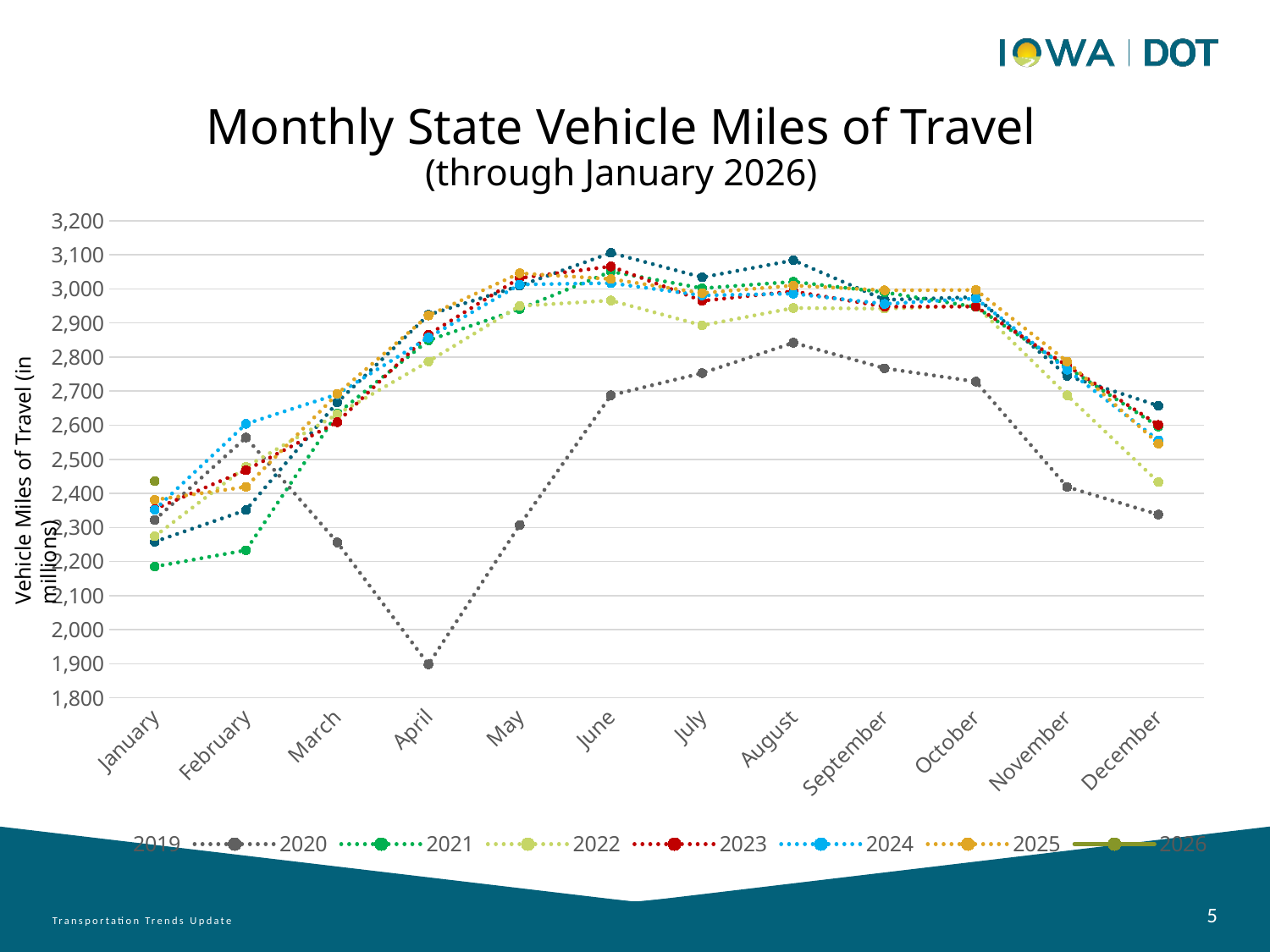
Is the 2020 value for April greater or less than 2,000? less Which series has the lowest value in December? 2020 How many months are shown along the x axis? 12 What is the title of the chart? Monthly State Vehicle Miles of Travel (through January 2026) Is the 2022 value for December greater or less than 2,500? less Is the 2020 value for June greater or less than 2,600? greater What kind of chart is shown on the slide? line chart Which month has the lowest value for the 2020 series? April Does the 2020 series rise or fall from March to April? fall Which month has the highest value for the 2020 series? August How many series does the legend list? 8